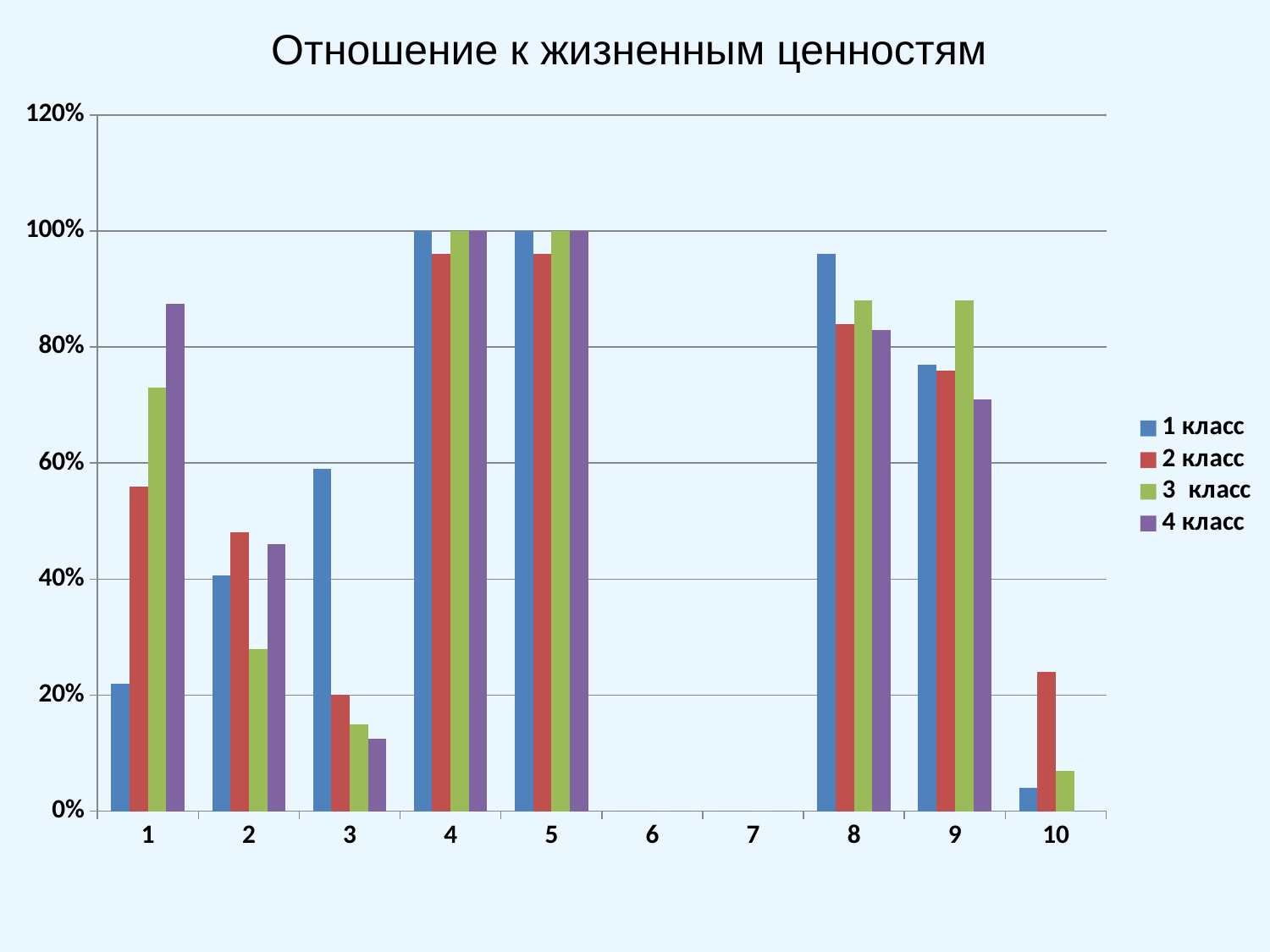
What is the title of the chart? Отношение к жизненным ценностям How many series does the legend list? 4 In category 3, which is larger: the value for 1 класс or for 2 класс? 1 класс In category 1, which series has the lowest value? 1 класс Is the value for 3 класс in category 2 greater or less than 40%? less Is the value for 4 класс in category 1 greater or less than 80%? greater In category 9, which series has the highest value? 3 класс What is the value for 4 класс in category 5? 100% Is the value for 1 класс in category 8 greater or less than 80%? greater What is the value for 1 класс in category 4? 100% What kind of chart is shown on the slide? bar chart How many categories are shown on the x axis? 10